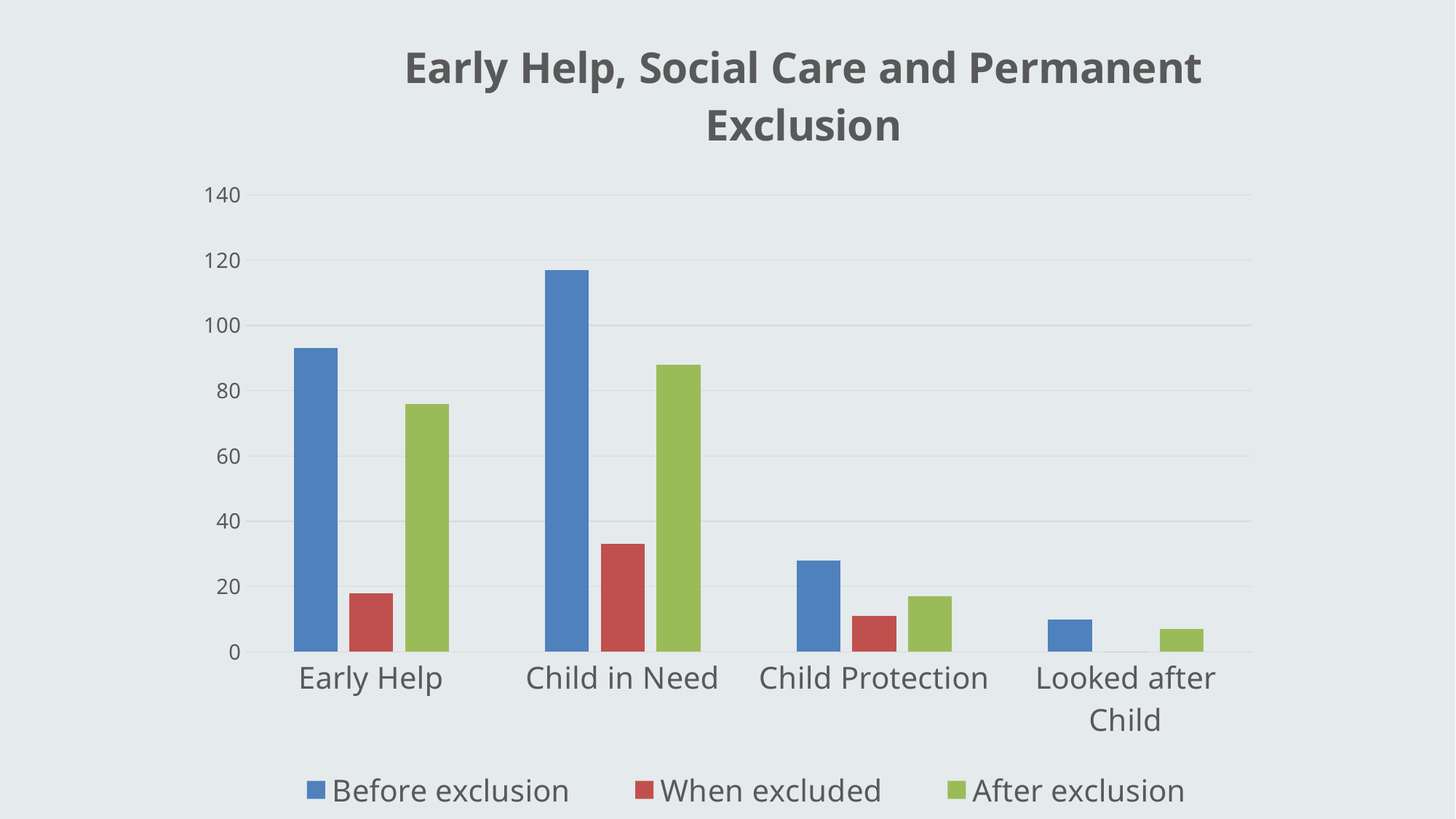
Which is larger: the 'After exclusion' value for Child Protection or the 'When excluded' value for Child Protection? After exclusion Is the 'When excluded' value for Child in Need greater or less than 40? less Which category has the highest 'After exclusion' value? Child in Need Which category has the lowest 'Before exclusion' value? Looked after Child Which is larger for Early Help: the 'Before exclusion' value or the 'After exclusion' value? Before exclusion What kind of chart is shown on the slide? bar chart Is the 'Before exclusion' value for Child in Need greater or less than 100? greater How many categories are shown on the x axis? 4 How many series does the legend list? 3 What is the title of the chart? Early Help, Social Care and Permanent Exclusion Which category has the highest 'Before exclusion' value? Child in Need Is the 'Before exclusion' value for Early Help greater or less than 100? less